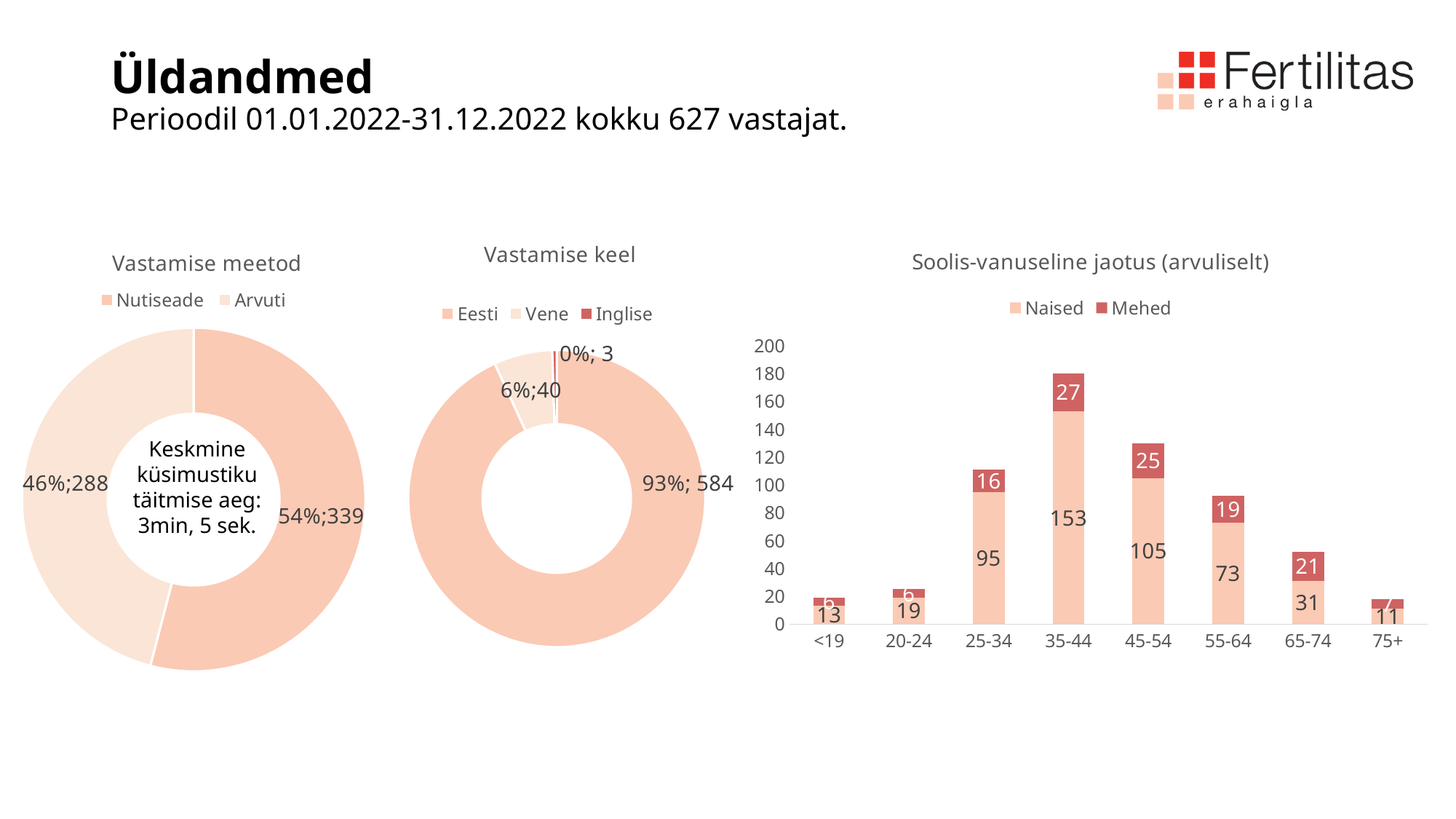
In the 'Vastamise keel' chart, which language has the smallest share? Inglise In the 'Soolis-vanuseline jaotus (arvuliselt)' chart, what is the total of the stacked bar for the 35-44 age group? 180 How many age groups are shown on the x axis of the 'Soolis-vanuseline jaotus (arvuliselt)' chart? 8 In the 'Soolis-vanuseline jaotus (arvuliselt)' chart, what is the difference between the Naised values for 25-34 and 55-64? 22 In the 'Vastamise keel' chart, what value is shown for Vene? 6%;40 In the 'Soolis-vanuseline jaotus (arvuliselt)' chart, what is the Mehed value for the 45-54 age group? 25 In the 'Vastamise meetod' chart, what value is shown for Arvuti? 46%;288 In the 'Vastamise keel' chart, what value is shown for Eesti? 93%; 584 In the 'Soolis-vanuseline jaotus (arvuliselt)' chart, what is the Naised value for the 35-44 age group? 153 In the 'Vastamise meetod' chart, what value is shown for Nutiseade? 54%;339 In the 'Soolis-vanuseline jaotus (arvuliselt)' chart, which age group has the highest Naised value? 35-44 How many series does the legend of the 'Vastamise keel' chart list? 3